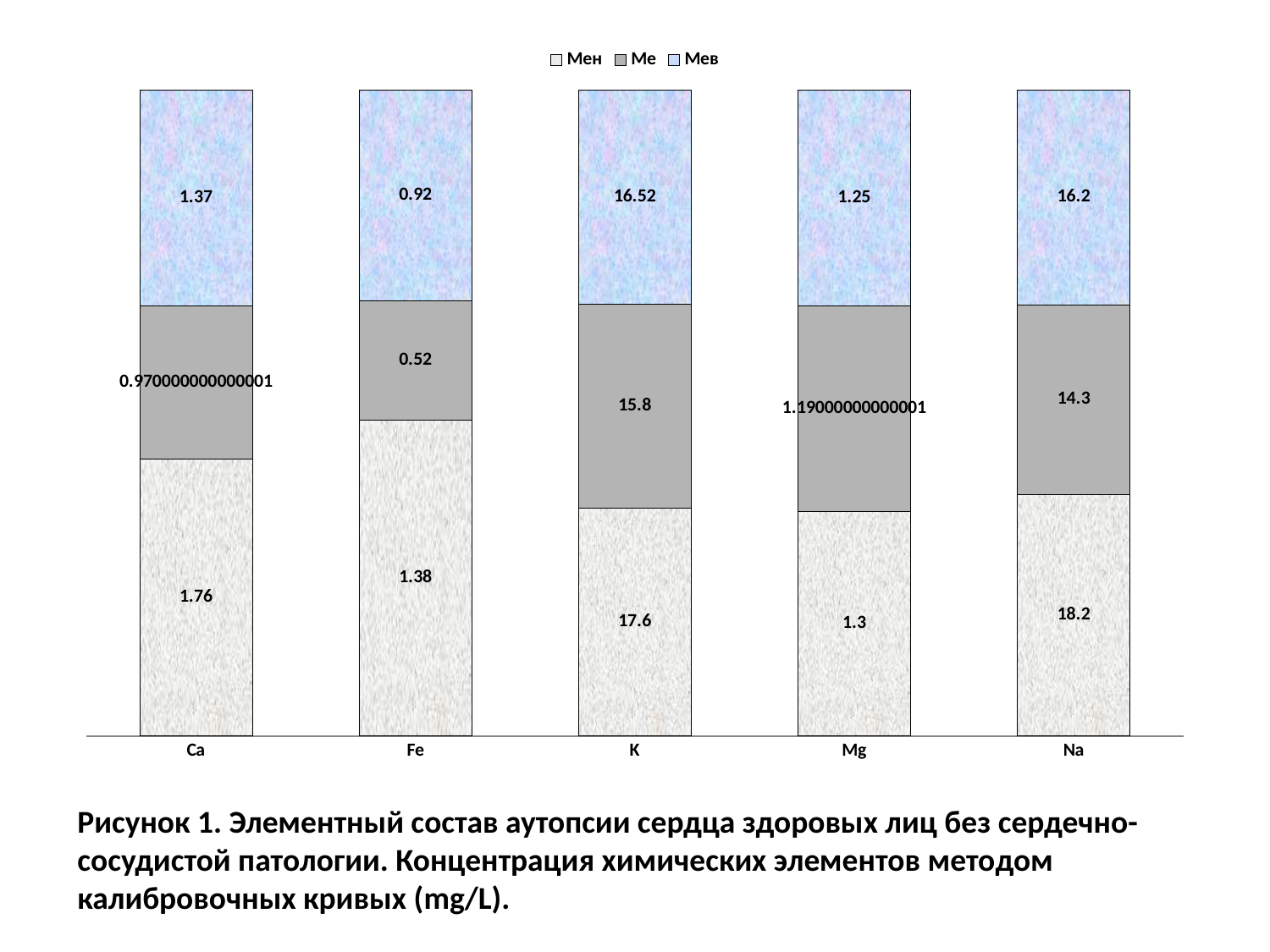
Which category has the highest value in the Мен series? Na What is the value of the Ме series for Ca, as printed on the slide? 0.970000000000001 What is the difference between the Мен values for Na and K? 0.6 What is the value of the Мен series for K? 17.6 How many categories are shown on the x axis? 5 How many series does the legend list? 3 Which category has the lowest value in the Мев series? Fe What is the difference between the Мев values for K and Na? 0.32 What kind of chart is shown on the slide? Stacked bar chart What is the value of the Мев series for Na? 16.2 Which is larger: the Ме value for K or the Ме value for Na? K What is the value of the Ме series for Fe? 0.52